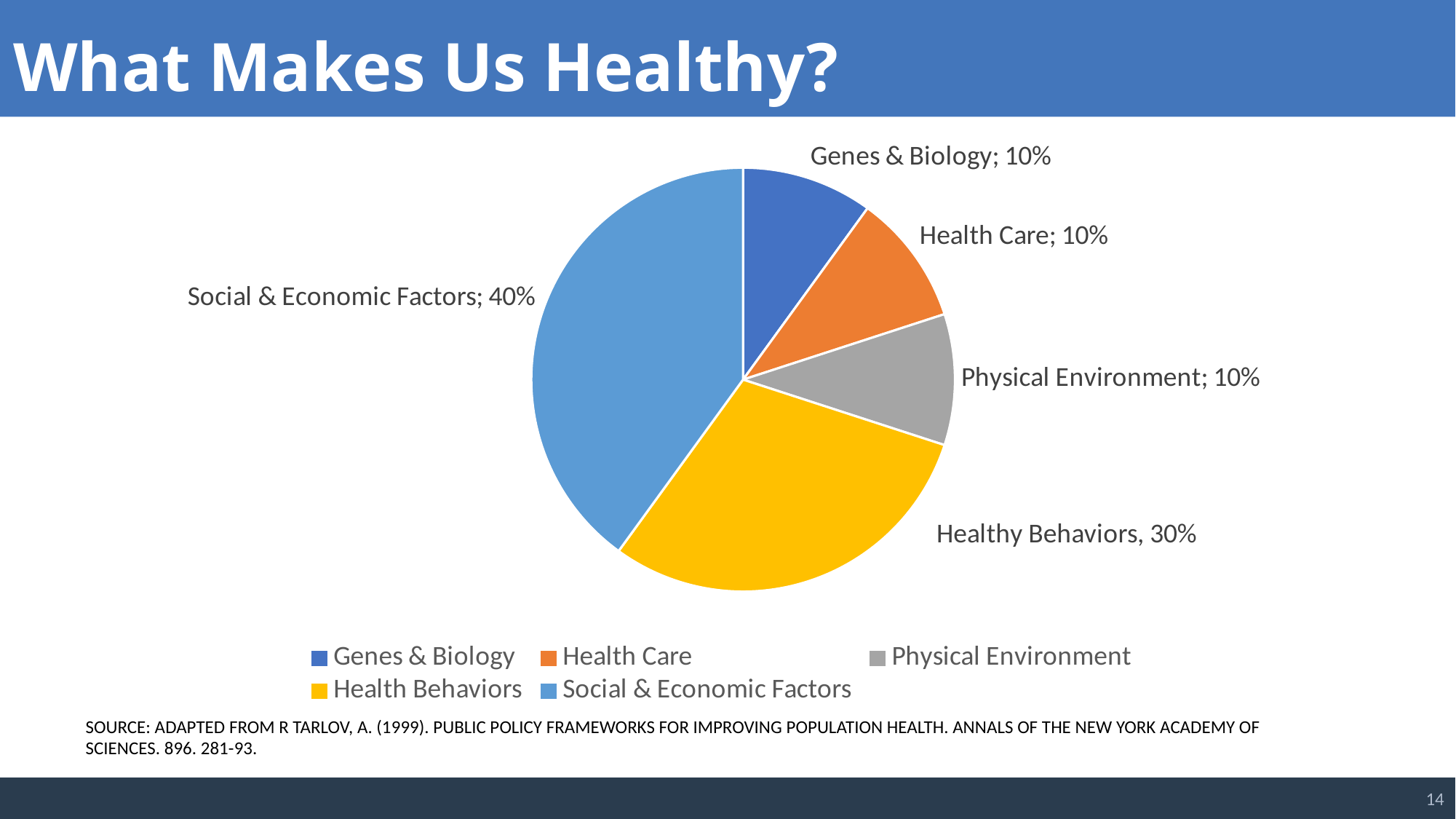
Which is larger, the Healthy Behaviors slice or the Genes & Biology slice? Healthy Behaviors What is the value shown for Health Care? 10% What is the combined share of Genes & Biology, Health Care and Physical Environment? 30% How many entries does the legend list? 5 What kind of chart is shown on the slide? Pie chart What colour is the Social & Economic Factors slice? Light blue What share of the pie is Social & Economic Factors? 40% How many categories are shown in the pie chart? 5 What is the value shown for Physical Environment? 10% Which category has the largest slice of the pie? Social & Economic Factors What is the value shown for Healthy Behaviors? 30% What is the difference between the Social & Economic Factors share and the Healthy Behaviors share? 10%